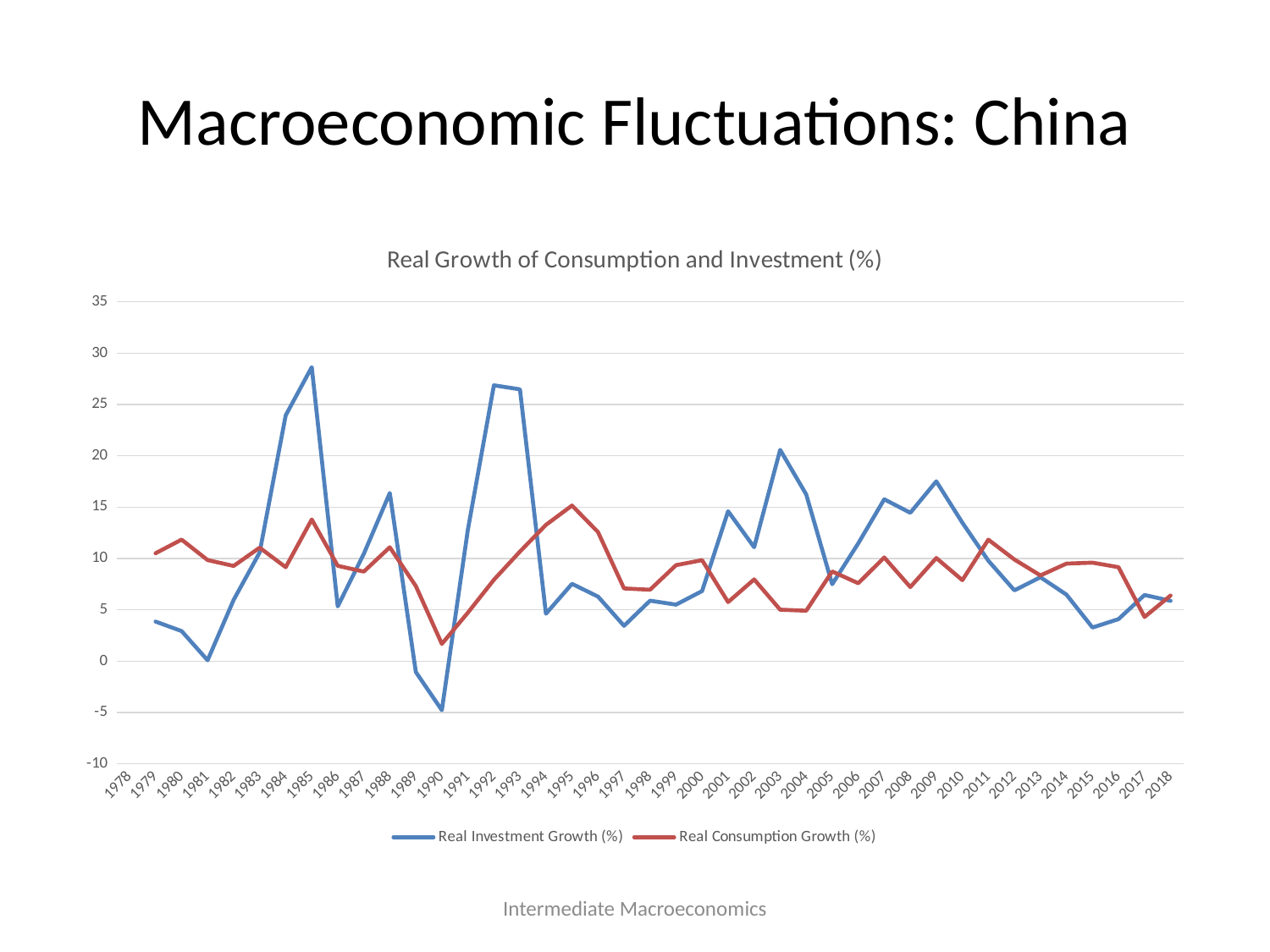
Does Real Investment Growth (%) rise or fall from 2009 to 2012? Fall How many series does the legend list? 2 Is the value of Real Consumption Growth (%) in 1995 greater or less than 10? greater In 1997, which series has the larger value, Real Investment Growth (%) or Real Consumption Growth (%)? Real Consumption Growth (%) Is the value of Real Investment Growth (%) in 1985 greater or less than 25? greater Which series is drawn in red? Real Consumption Growth (%) In which year does Real Consumption Growth (%) reach its highest value? 1995 In which year does Real Investment Growth (%) reach its highest value? 1985 What kind of chart is shown on the slide? Line chart What is the title of the chart? Real Growth of Consumption and Investment (%) In which year does Real Investment Growth (%) reach its lowest value? 1990 Is the value of Real Investment Growth (%) in 1990 greater or less than 0? less